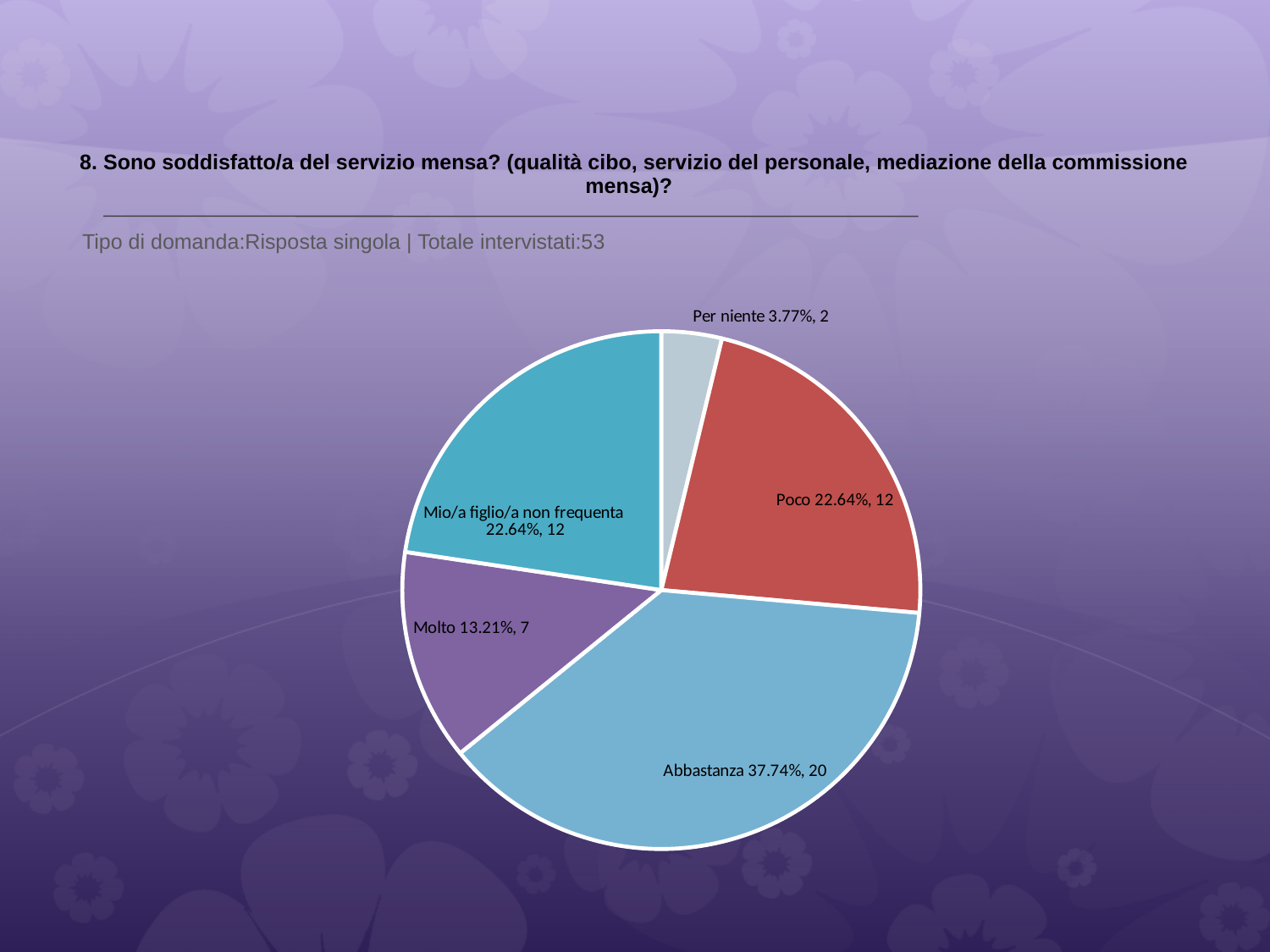
What kind of chart is shown on the slide? pie chart What percentage share does the 'Poco' slice have? 22.64% How many respondents answered 'Molto'? 7 Which has more respondents, 'Molto' or 'Mio/a figlio/a non frequenta'? Mio/a figlio/a non frequenta What percentage share does the 'Abbastanza' slice have? 37.74% How many slices does the pie chart have? 5 What is the difference in respondent count between 'Abbastanza' and 'Poco'? 8 Which category has the smallest slice? Per niente What colour is the 'Abbastanza' slice? light blue How many respondents answered 'Per niente'? 2 What is the total number of respondents stated on the slide? 53 Which category has the largest slice? Abbastanza